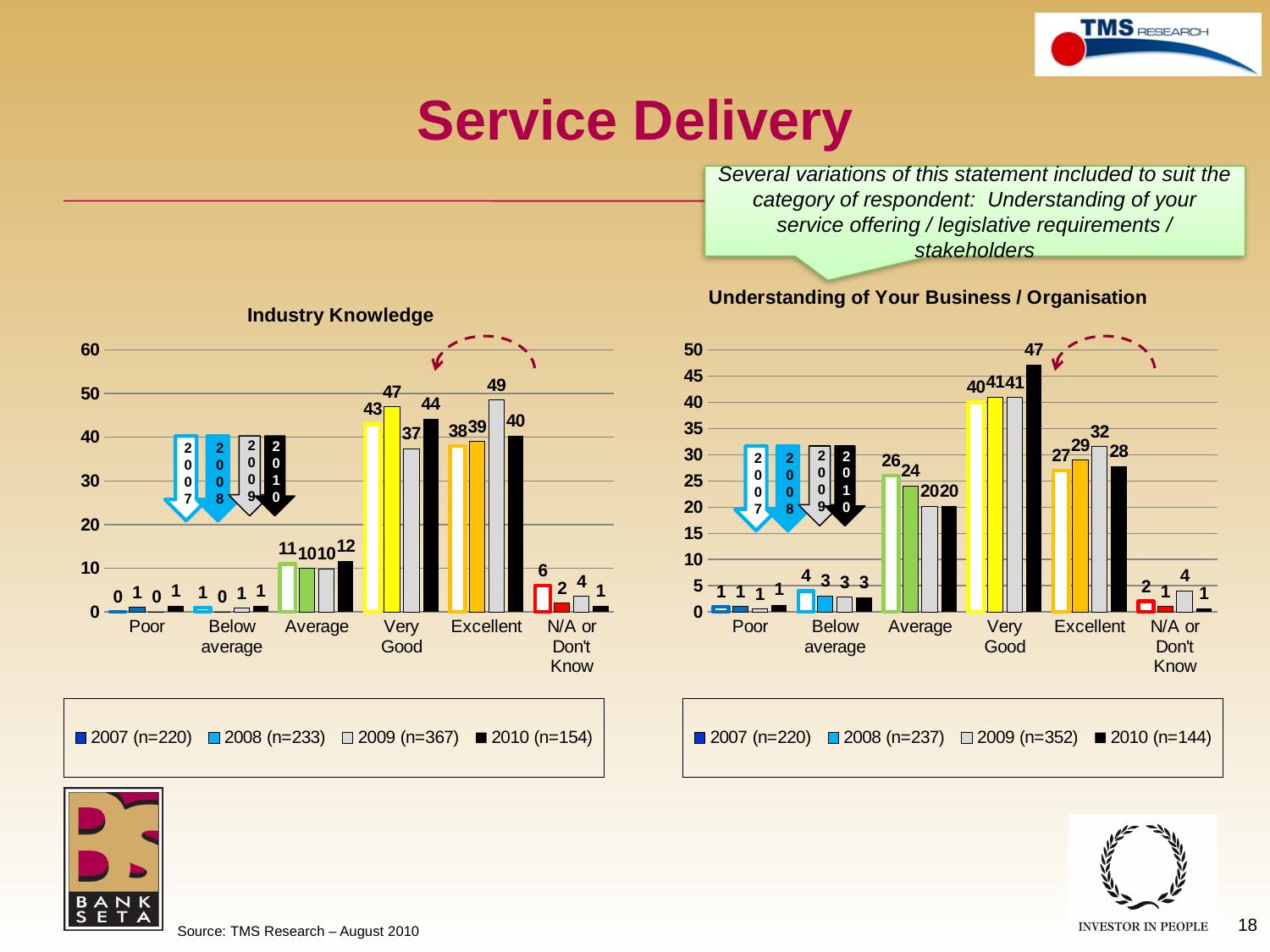
In the Understanding of Your Business / Organisation chart, which year has the highest value in the Excellent category? 2009 In the Industry Knowledge chart, what is the value for 2010 in the Very Good category? 44 In the Industry Knowledge chart, what is the value for 2009 in the Excellent category? 49 In the Understanding of Your Business / Organisation chart, what is the value for 2007 in the Average category? 26 In the Industry Knowledge chart, which year has the highest value in the Very Good category? 2008 In the Understanding of Your Business / Organisation chart, is the 2010 value for Excellent larger or smaller than the 2009 value for Excellent? smaller How many series does the legend of the Industry Knowledge chart list? 4 In the Understanding of Your Business / Organisation chart, what is the difference between the 2007 and 2010 values for Average? 6 In the Understanding of Your Business / Organisation chart, what is the value for 2010 in the Very Good category? 47 What type of chart is the Understanding of Your Business / Organisation chart? bar chart In the Industry Knowledge chart, which year has the lowest value in the N/A or Don't Know category? 2010 In the Industry Knowledge chart, what is the difference between the 2009 and 2010 values for Excellent? 9